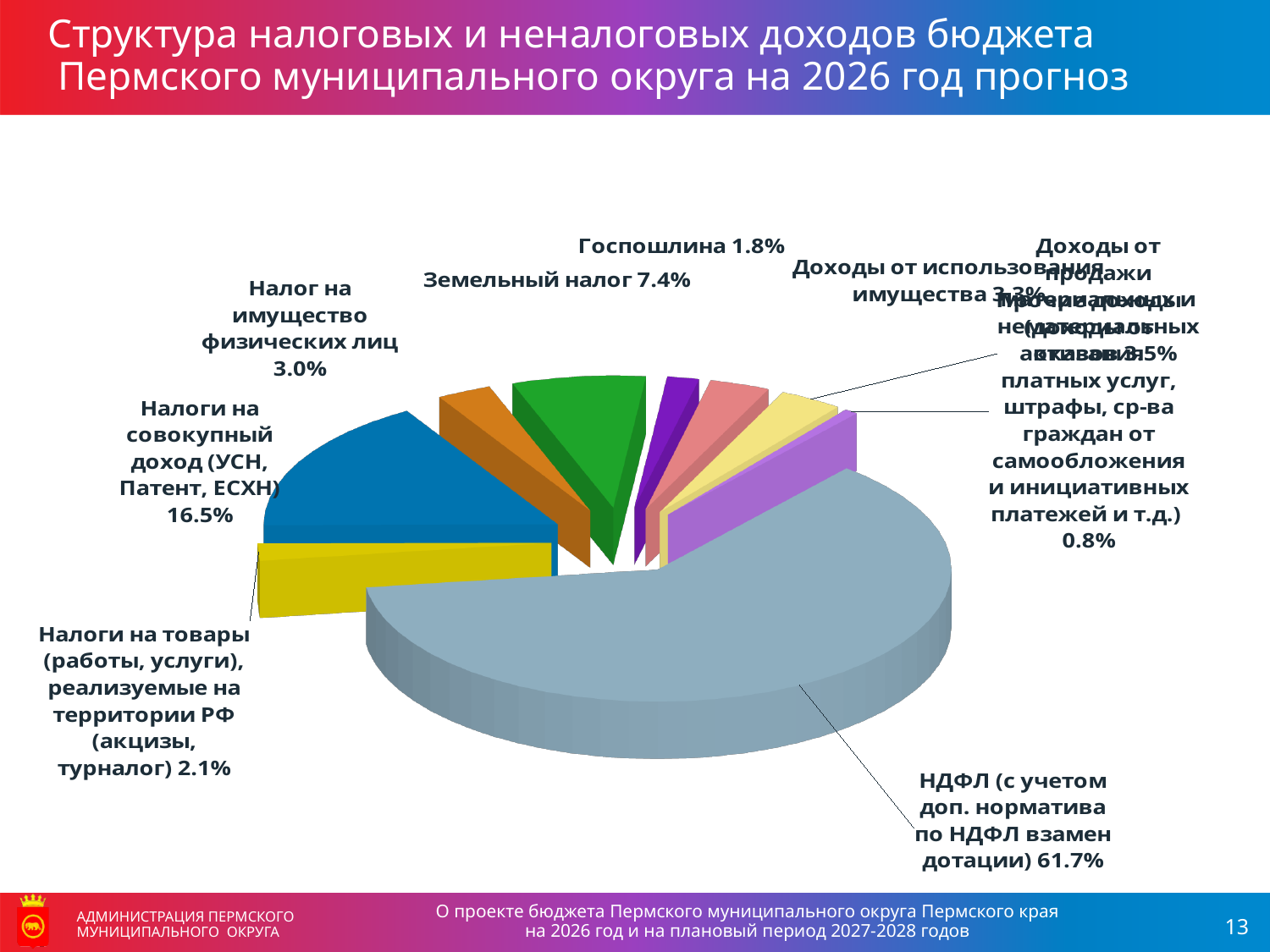
By how many percentage points does the НДФЛ share exceed the share for Налоги на совокупный доход (УСН, Патент, ЕСХН)? 45.2 percentage points What year does the slide title say the forecast is for? 2026 Which is larger: the share for Земельный налог or the share for Налог на имущество физических лиц? Земельный налог How many slices does the pie chart have? 9 What kind of chart is shown on the slide? pie chart What share is shown for Земельный налог? 7.4% What share is shown for Налог на имущество физических лиц? 3.0% Which category has the largest share of the pie? НДФЛ (с учетом доп. норматива по НДФЛ взамен дотации) What share is shown for Налоги на совокупный доход (УСН, Патент, ЕСХН)? 16.5% What share is shown for Госпошлина? 1.8% What share of the budget revenue is НДФЛ (с учетом доп. норматива по НДФЛ взамен дотации)? 61.7% What share is shown for Налоги на товары (работы, услуги), реализуемые на территории РФ (акцизы, турналог)? 2.1%